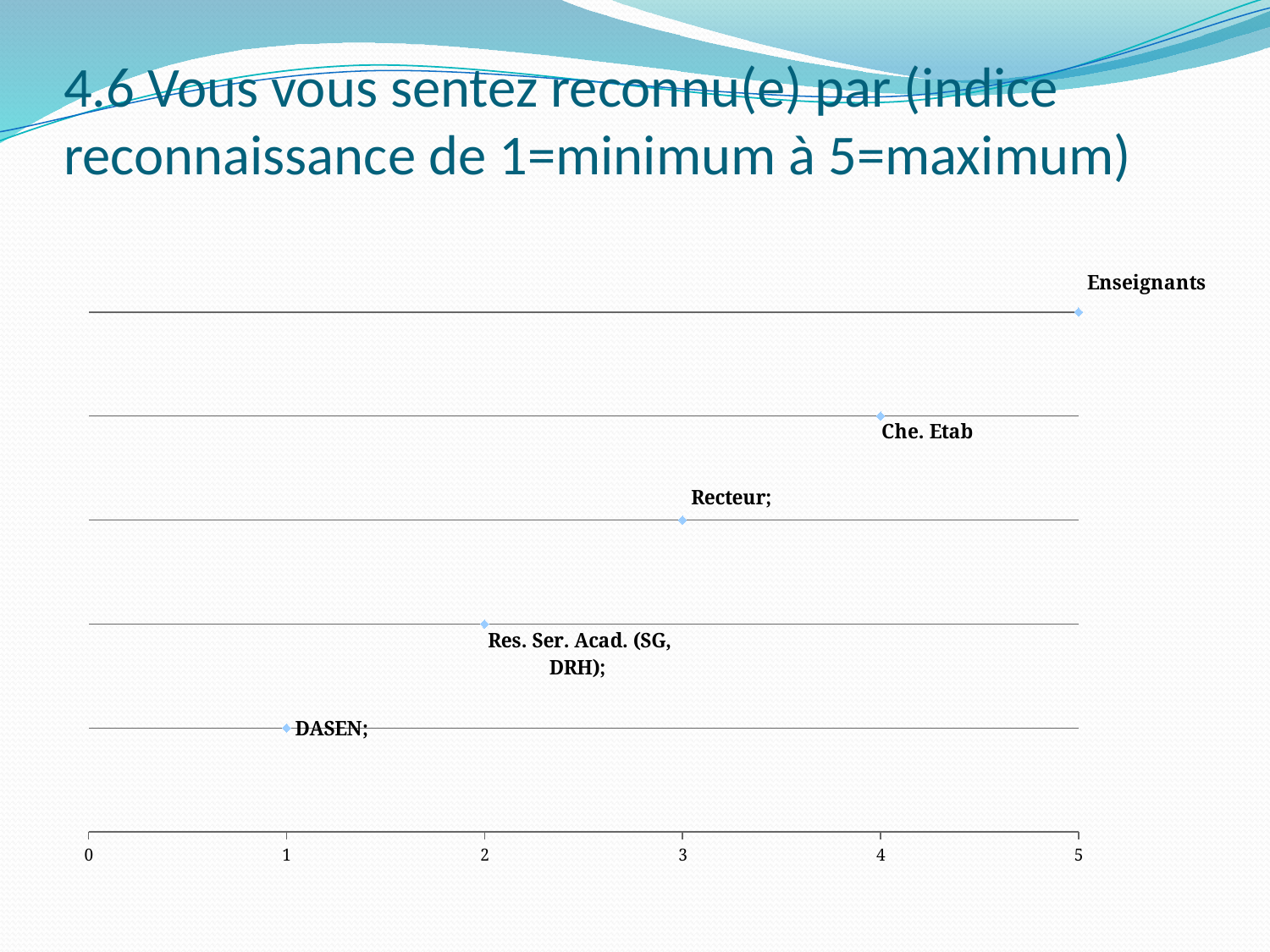
Is the value for Che. Etab greater or less than 3? greater How many categories are plotted on the chart? 5 Which category has the highest recognition index? Enseignants What value does the point for Res. Ser. Acad. (SG, DRH) land on? 2 What value does the point for Enseignants land on? 5 What is the difference between the values for Enseignants and DASEN? 4 What is the maximum value shown on the horizontal axis? 5 Which category has the lowest recognition index? DASEN What value does the point for Recteur land on? 3 What value does the point for DASEN land on? 1 Which is larger, the value for Che. Etab or the value for Recteur? Che. Etab What value does the point for Che. Etab land on? 4